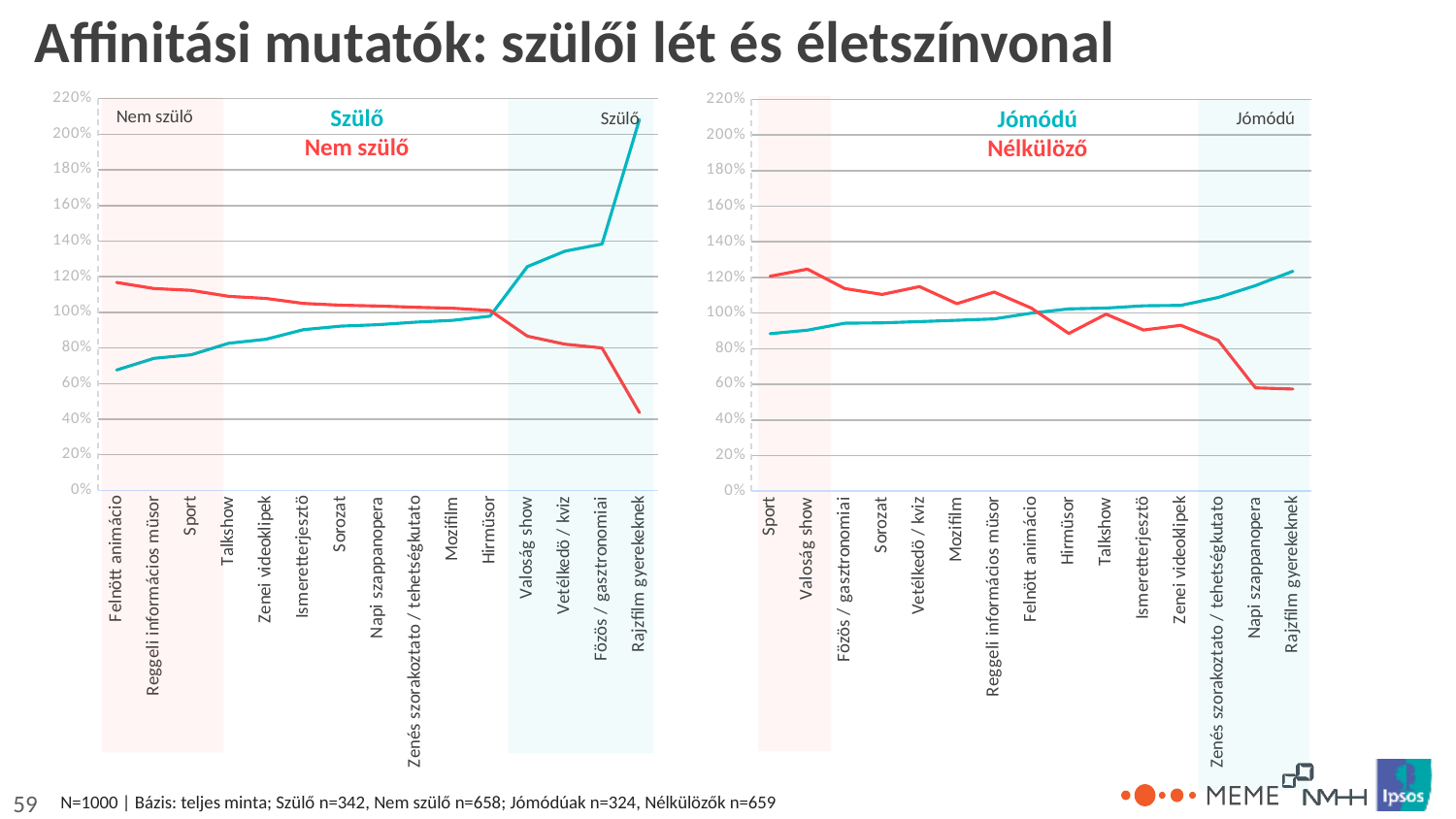
How many categories are on the x axis of the right chart (Jómódú / Nélkülöző)? 15 In the right chart, for which category is the Jómódú line lowest? Sport In the left chart, does the Nem szülő line rise or fall from left to right along the x axis? fall In the right chart, for which category is the Nélkülöző line highest? Valóság show In the left chart, for which category is the Szülő line highest? Rajzfilm gyerekeknek In the right chart, what colour is the Jómódú line? teal In the left chart, which series has the larger value for Felnőtt animáció, Szülő or Nem szülő? Nem szülő In the left chart, for which category is the Nem szülő line lowest? Rajzfilm gyerekeknek In the left chart, is the Szülő value for Rajzfilm gyerekeknek greater or less than 200%? greater How many series does the left chart (Szülő / Nem szülő) show? 2 What kind of chart is the left chart (Szülő / Nem szülő)? line chart